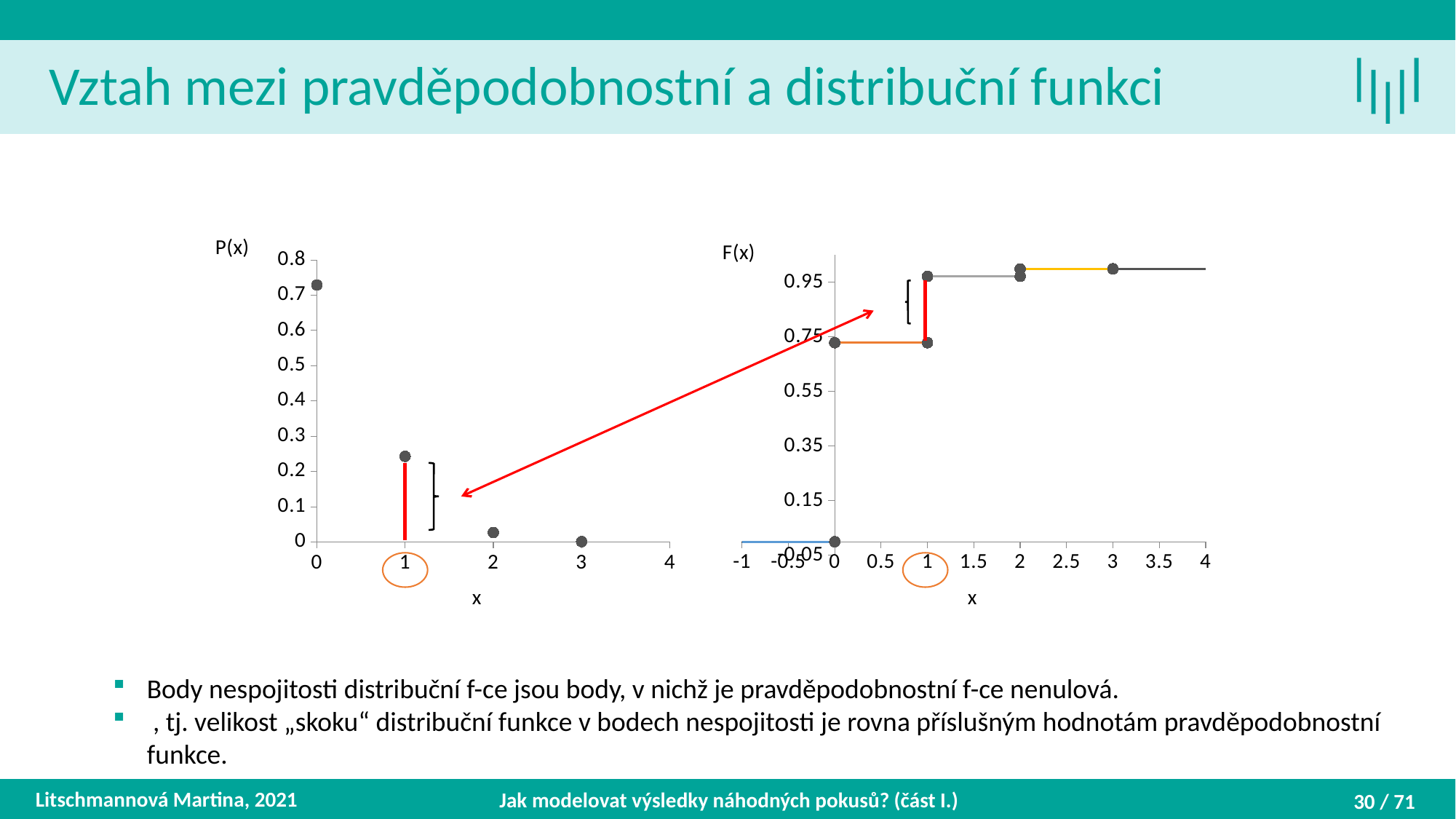
What is the label of the vertical axis on the left chart? P(x) On the right chart (F(x)), is the value at x = -0.5 greater or less than 0.15? less On the left chart (P(x)), is the value at x = 2 greater or less than 0.1? less On the left chart (P(x)), is the value at x = 1 greater or less than 0.3? less Which x value is circled on the horizontal axis of both charts? 1 On the left chart (P(x)), which is larger, the value at x = 0 or the value at x = 1? x = 0 On the right chart (F(x)), do the values rise or fall as x increases? rise On the left chart (P(x)), how many data points are plotted? 4 On the left chart (P(x)), at which x value is the plotted probability highest? 0